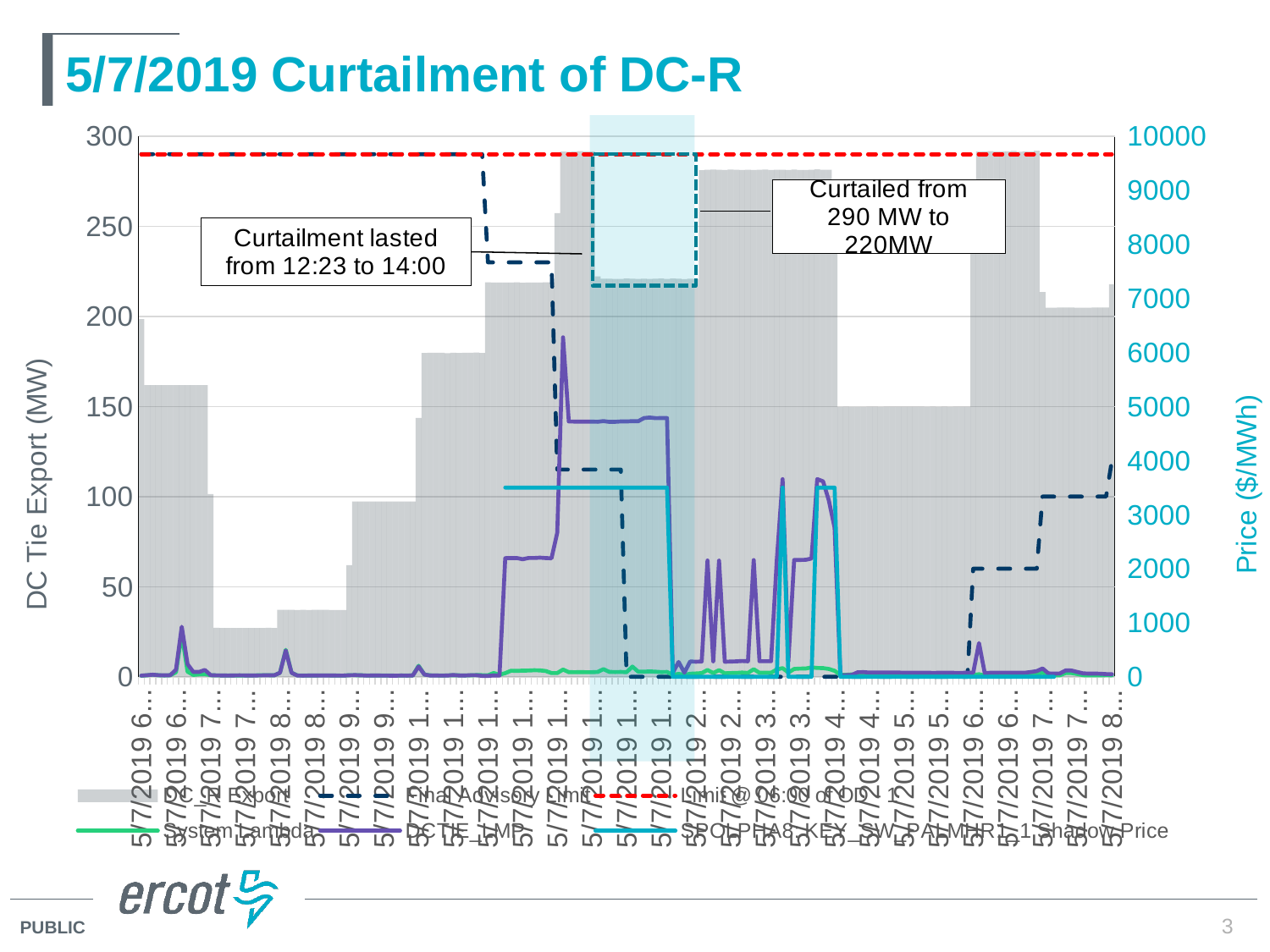
According to the annotation, what value was the DC-R export curtailed to? 220MW Is the peak value of the DCTIE_LMP line greater or less than 5000 $/MWh? greater How many series does the legend list? 6 What is the title of the slide's chart? 5/7/2019 Curtailment of DC-R Based on the annotation, by how many MW was the export curtailed (290 MW to 220 MW)? 70 MW Which series is drawn as the red dashed line? Limit @ 06:00 of OD-1 According to the annotation, during what time period did the curtailment last? from 12:23 to 14:00 Is the value of the Limit @ 06:00 of OD-1 line greater or less than 250 MW? greater What is the maximum value shown on the left-hand DC Tie Export axis? 300 Is the plateau value of the SPOLPHA8_KEY_SW_PALMHR1_1 Shadow Price line greater or less than 3000 $/MWh? greater According to the annotation, from what value was the DC-R export curtailed? 290 MW What is the maximum value shown on the right-hand Price axis? 10000